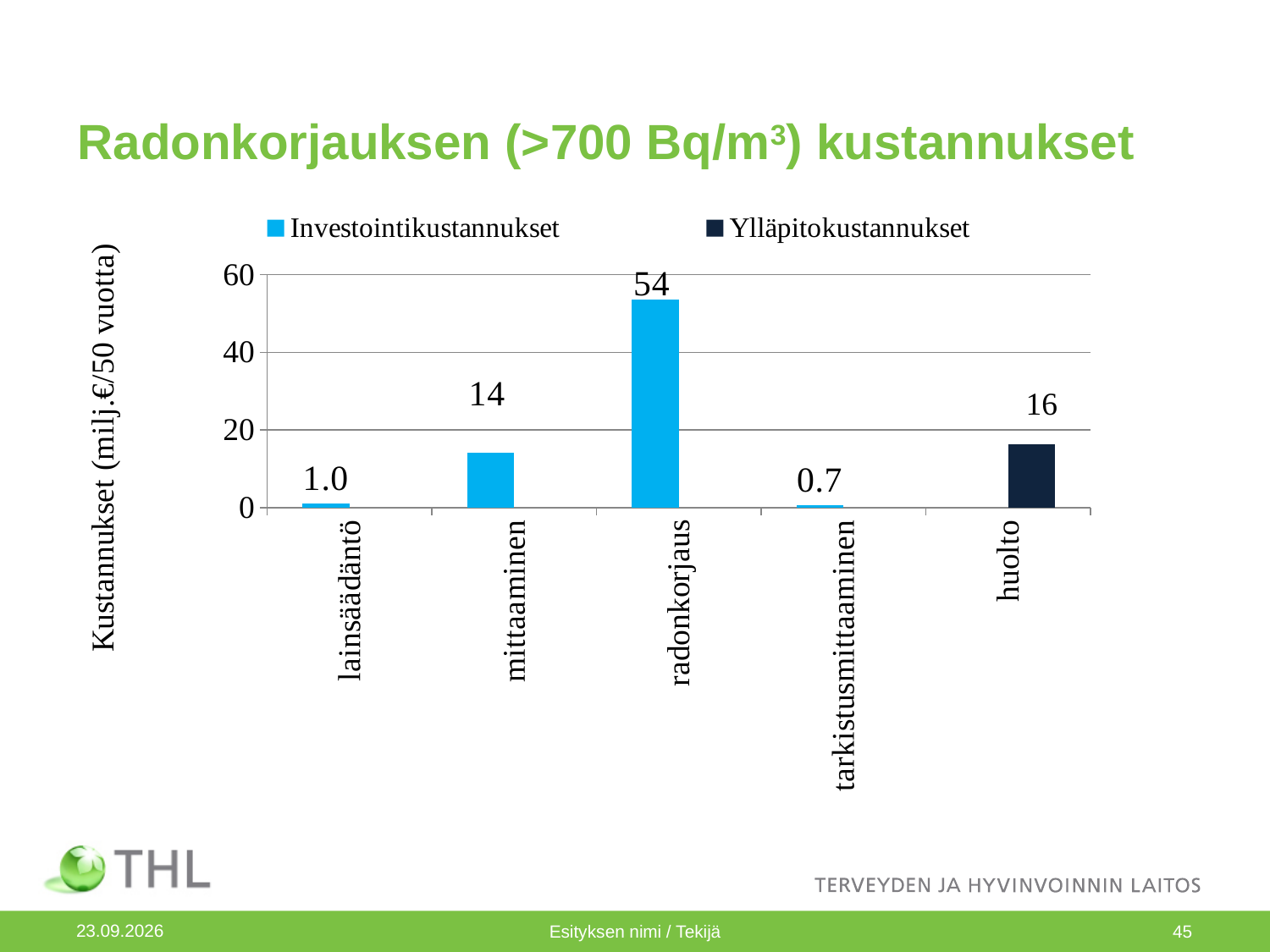
Which category has the lowest value? tarkistusmittaaminen What is the value for tarkistusmittaaminen? 0.7 What is the value for huolto? 16 What is the value for mittaaminen? 14 Which category has the highest value? radonkorjaus What is the difference between the values for radonkorjaus and mittaaminen? 40 What is the value for lainsäädäntö? 1.0 What kind of chart is shown on the slide? bar chart How many series does the legend list? 2 Which is larger, the value for huolto or the value for mittaaminen? huolto How many categories are shown on the x axis? 5 What is the value for radonkorjaus? 54